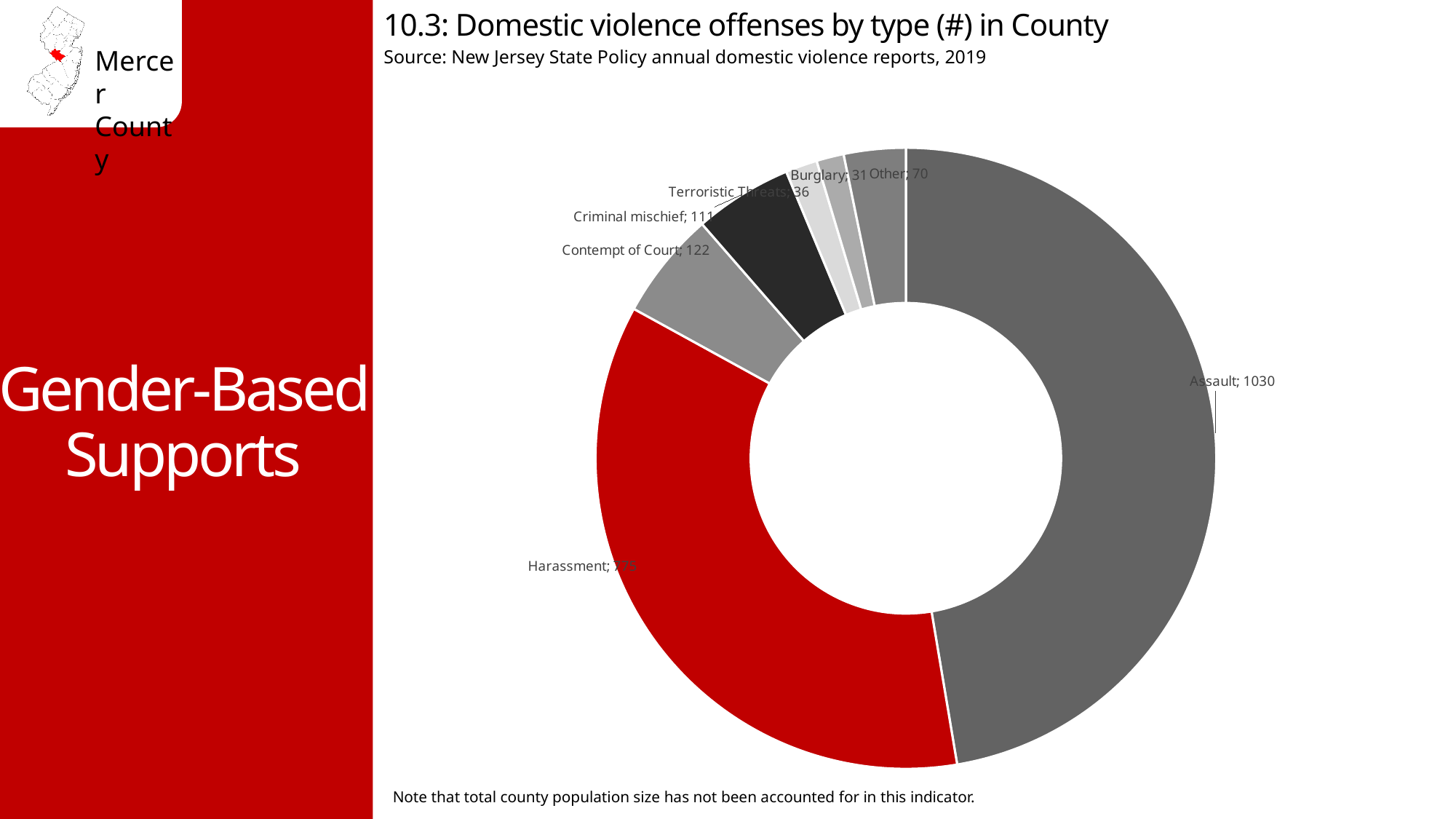
What is the difference between Contempt of Court and Criminal mischief offenses? 11 What type of chart is shown on the slide? Doughnut (pie) chart What is the number of Criminal mischief offenses? 111 How many offense types are shown in the chart? 7 What is the number of Contempt of Court offenses? 122 What is the number of Terroristic Threats offenses? 36 Which offense type has the highest number of offenses? Assault Which is larger, the Assault slice or the Harassment slice? Assault What is the number of offenses in the Other category? 70 Which offense type has the lowest number of offenses? Burglary What is the number of Assault offenses? 1030 What is the number of Burglary offenses? 31